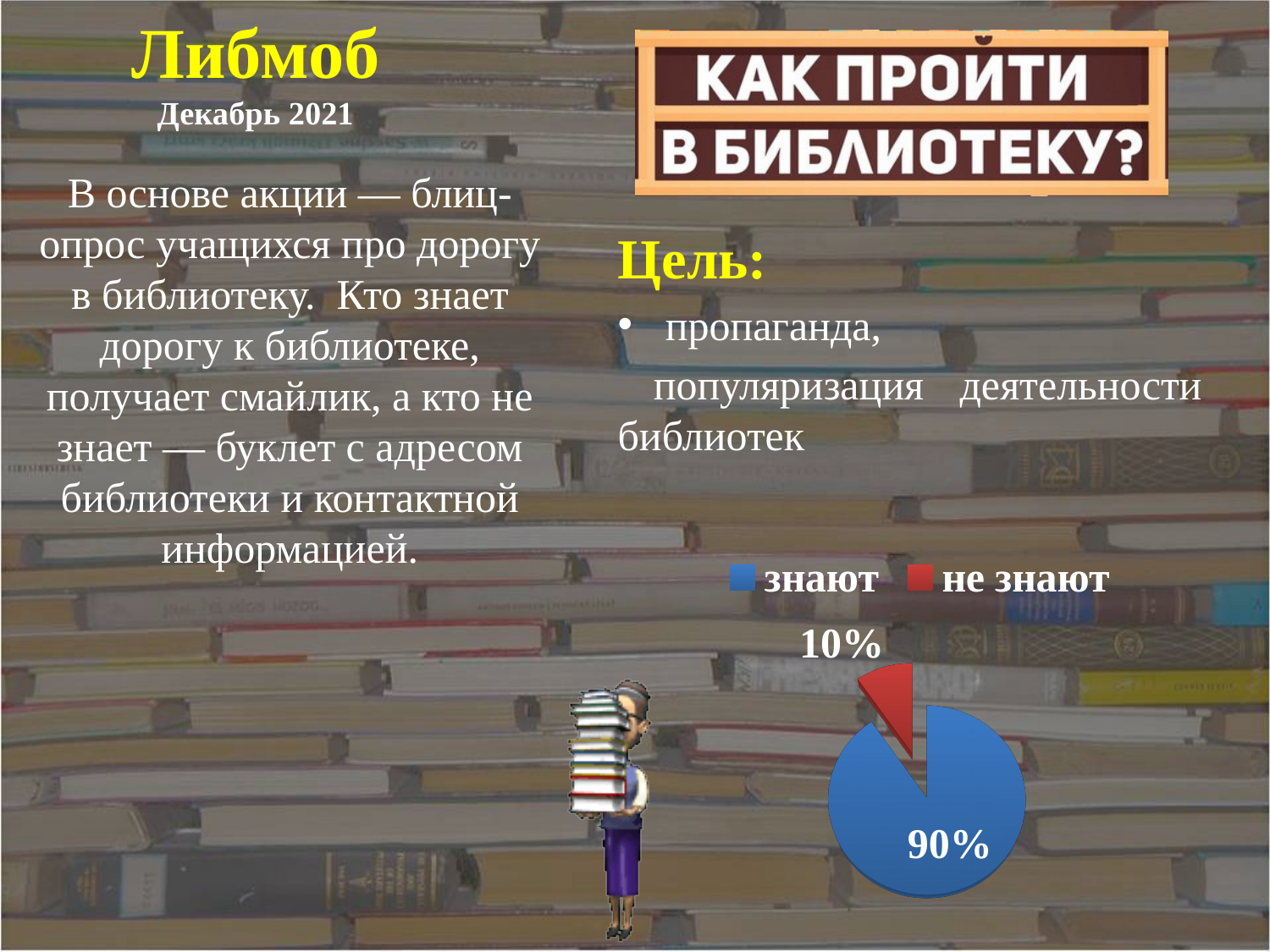
Which slice of the pie chart is the largest? знают What kind of chart is shown on the slide? pie chart What is the difference in percentage points between the "знают" and "не знают" slices? 80% What colour is the "не знают" slice in the pie chart? red How many entries does the legend of the pie chart list? 2 What colour is the "знают" slice in the pie chart? blue Which slice of the pie chart is the smallest? не знают How many slices does the pie chart have? 2 What share of the pie does the "не знают" slice represent? 10% Which is larger in the pie chart, "знают" or "не знают"? знают What share of the pie does the "знают" slice represent? 90%